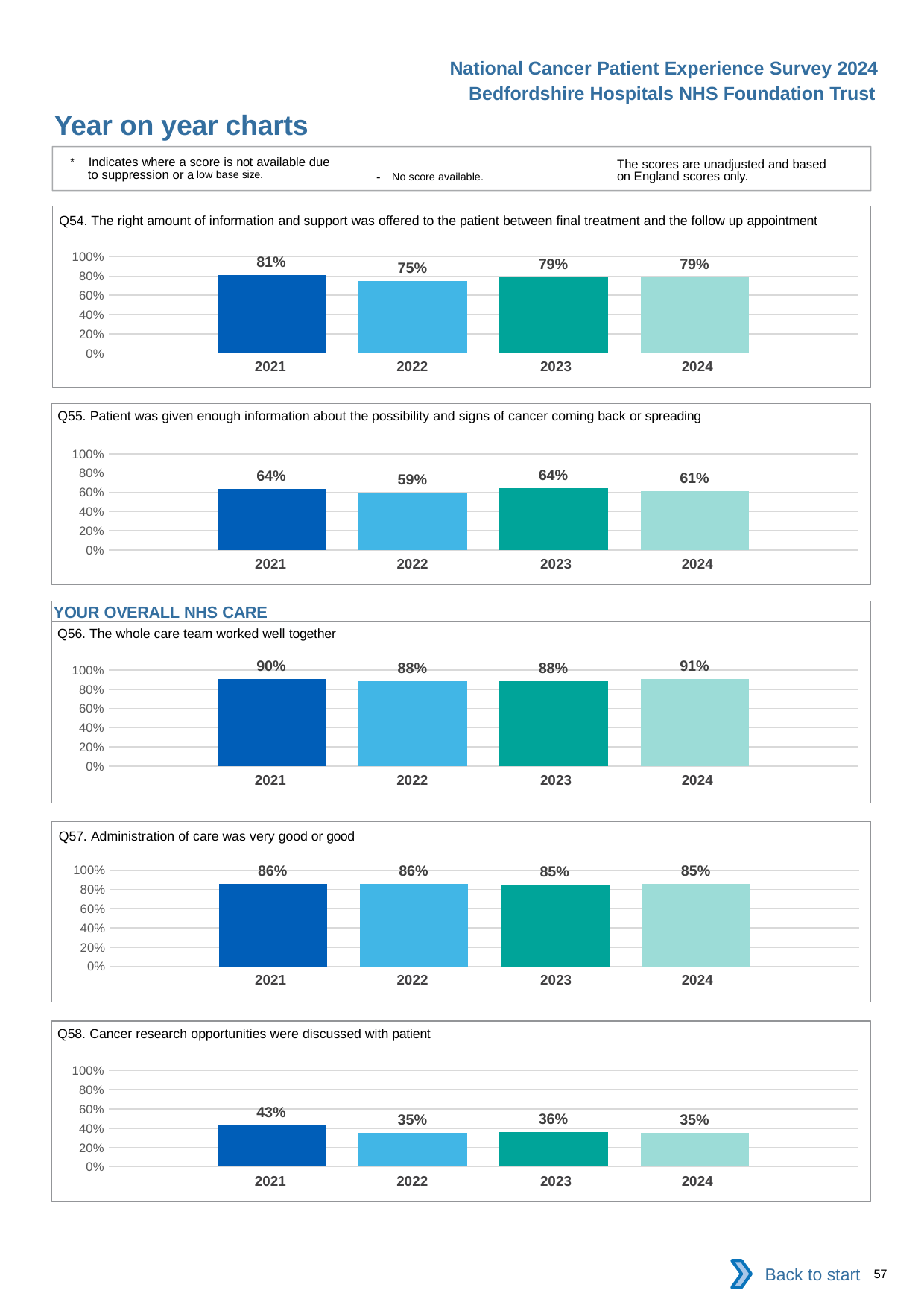
In the Q56 chart, which year has the highest value? 2024 In the Q57 chart, what is the value for 2024? 85% How many years are shown on the x axis of the Q58 chart? 4 In the Q55 chart, what is the difference between the 2021 and 2022 values? 5% In the Q55 chart, what is the value for 2024? 61% In the Q56 chart, what is the value for 2022? 88% In the Q58 chart, what is the value for 2021? 43% In the Q57 chart, is the value for 2021 larger or smaller than the value for 2023? larger In the Q54 chart, which year has the lowest value? 2022 In the Q58 chart, what is the difference between the 2021 and 2024 values? 8% What type of chart is the Q54 chart? bar chart In the Q54 chart, what is the value for 2021? 81%